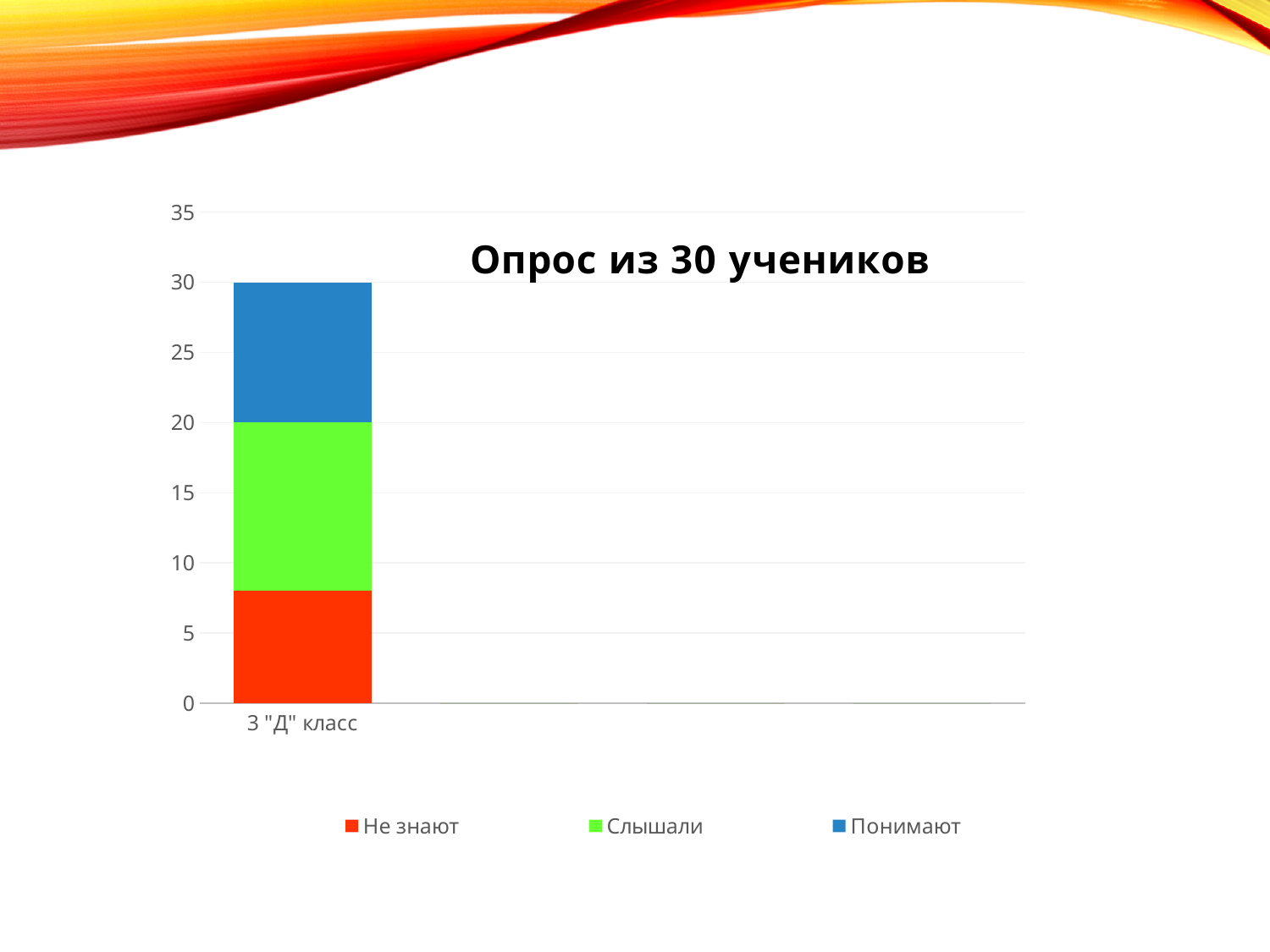
Is the value for Понимают greater or less than 5? greater What is the value of the Понимают segment for 3 "Д" класс? 10 What is the total height of the stacked bar for 3 "Д" класс? 30 Which is larger for 3 "Д" класс, Слышали or Не знают? Слышали What colour represents the Не знают series in the legend? Red What kind of chart is shown on the slide? Stacked bar chart What is the title of the chart? Опрос из 30 учеников Which series has the largest segment in the bar for 3 "Д" класс? Слышали Is the value for Не знают greater or less than 10? less How many series does the legend list? 3 How many categories are shown on the x axis? 1 Is the value for Слышали greater or less than 10? greater